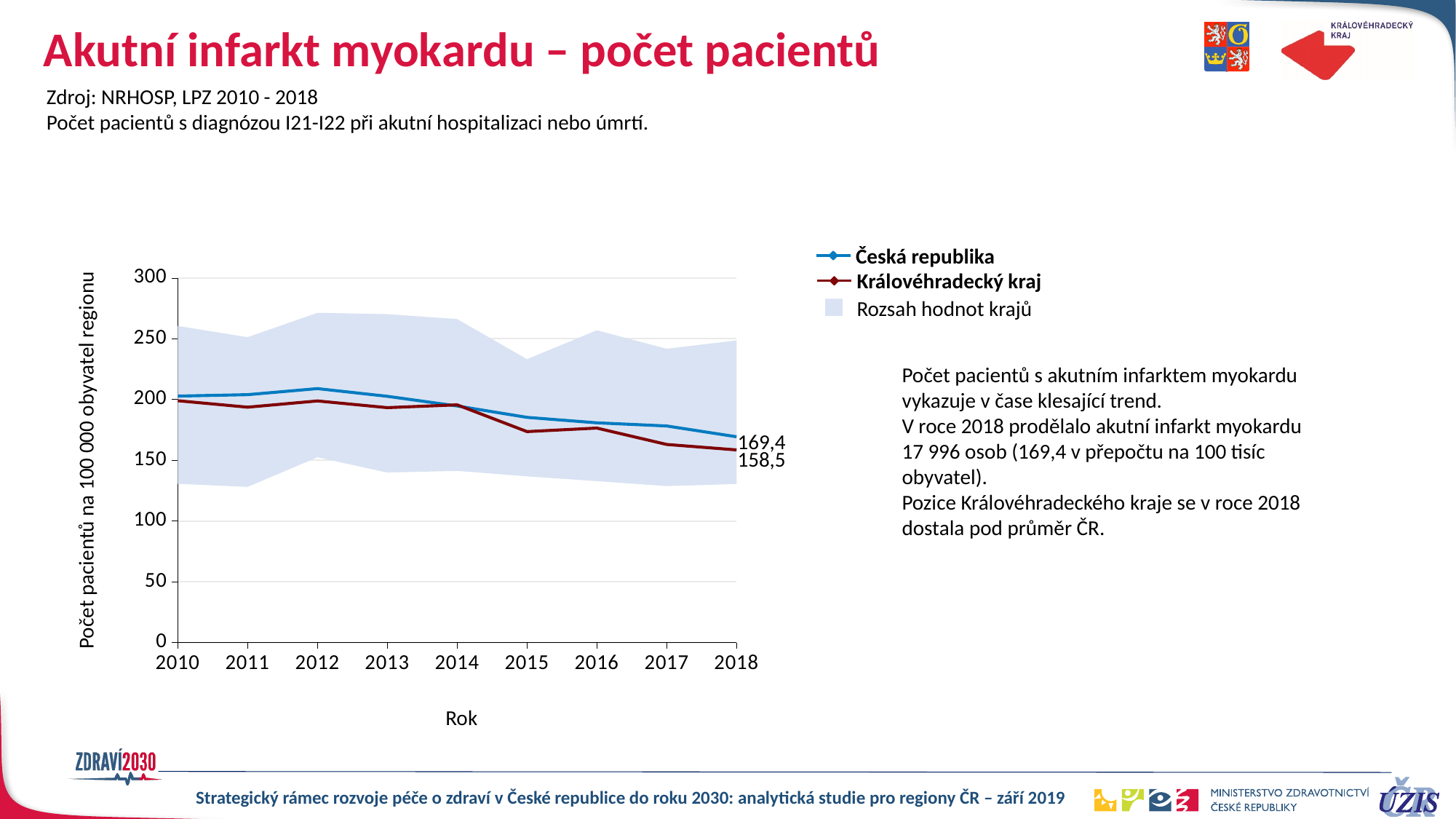
Does the Česká republika line rise or fall from 2010 to 2018? Falls In 2018, which series has the larger value, Česká republika or Královéhradecký kraj? Česká republika In which year is the Královéhradecký kraj value lowest? 2018 What kind of chart is shown on the slide? Line chart Is the value for Česká republika in 2012 greater or less than 200? greater What is the difference between the Česká republika and Královéhradecký kraj values in 2018? 10,9 Is the value for Královéhradecký kraj in 2015 greater or less than 200? less How many years are plotted on the x axis? 9 What is the value for Královéhradecký kraj in 2018? 158,5 What is the title of the x axis? Rok What is the value for Česká republika in 2018? 169,4 How many entries does the legend list? 3